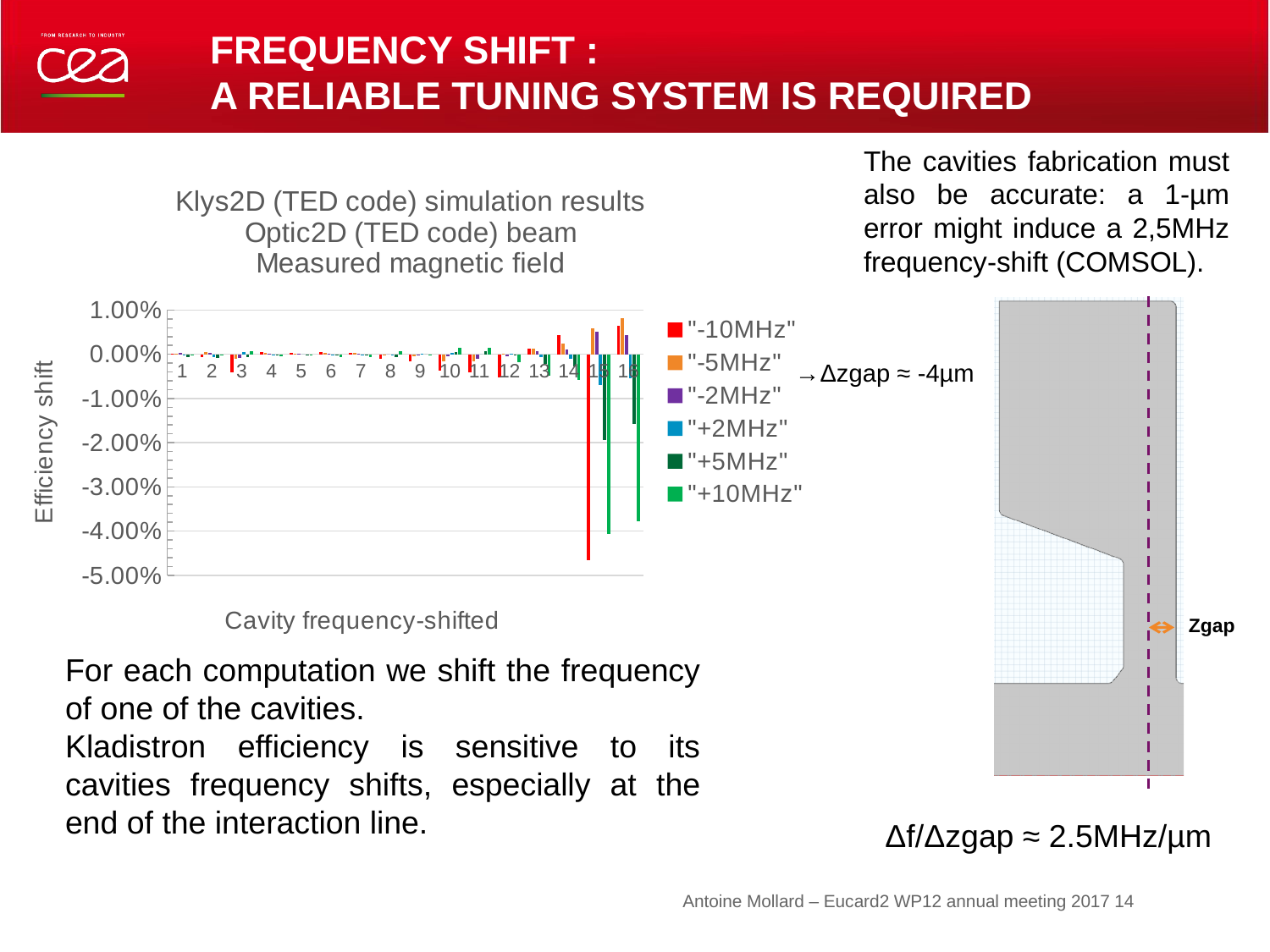
Do the efficiency shifts become larger in magnitude toward the beginning or toward the end of the cavity sequence on the x axis? toward the end Is the efficiency shift for the "-10MHz" series at cavity 15 greater or less than -4.00%? less Which of the two has a lower efficiency shift: the "-10MHz" series at cavity 15 or the "-10MHz" series at cavity 3? cavity 15 What is the label of the vertical axis of the chart? Efficiency shift Is the efficiency shift for the "+10MHz" series at cavity 16 greater or less than -3.00%? less Which series in the legend is shown in red? "-10MHz" How many cavity categories are plotted along the x axis of the chart? 16 For the "-10MHz" series, which cavity shows the lowest efficiency shift? 15 What kind of chart is shown on the slide? bar chart What is the label of the horizontal axis of the chart? Cavity frequency-shifted Is the efficiency shift for the "-10MHz" series at cavity 1 greater or less than -1.00%? greater How many series does the chart legend list? 6